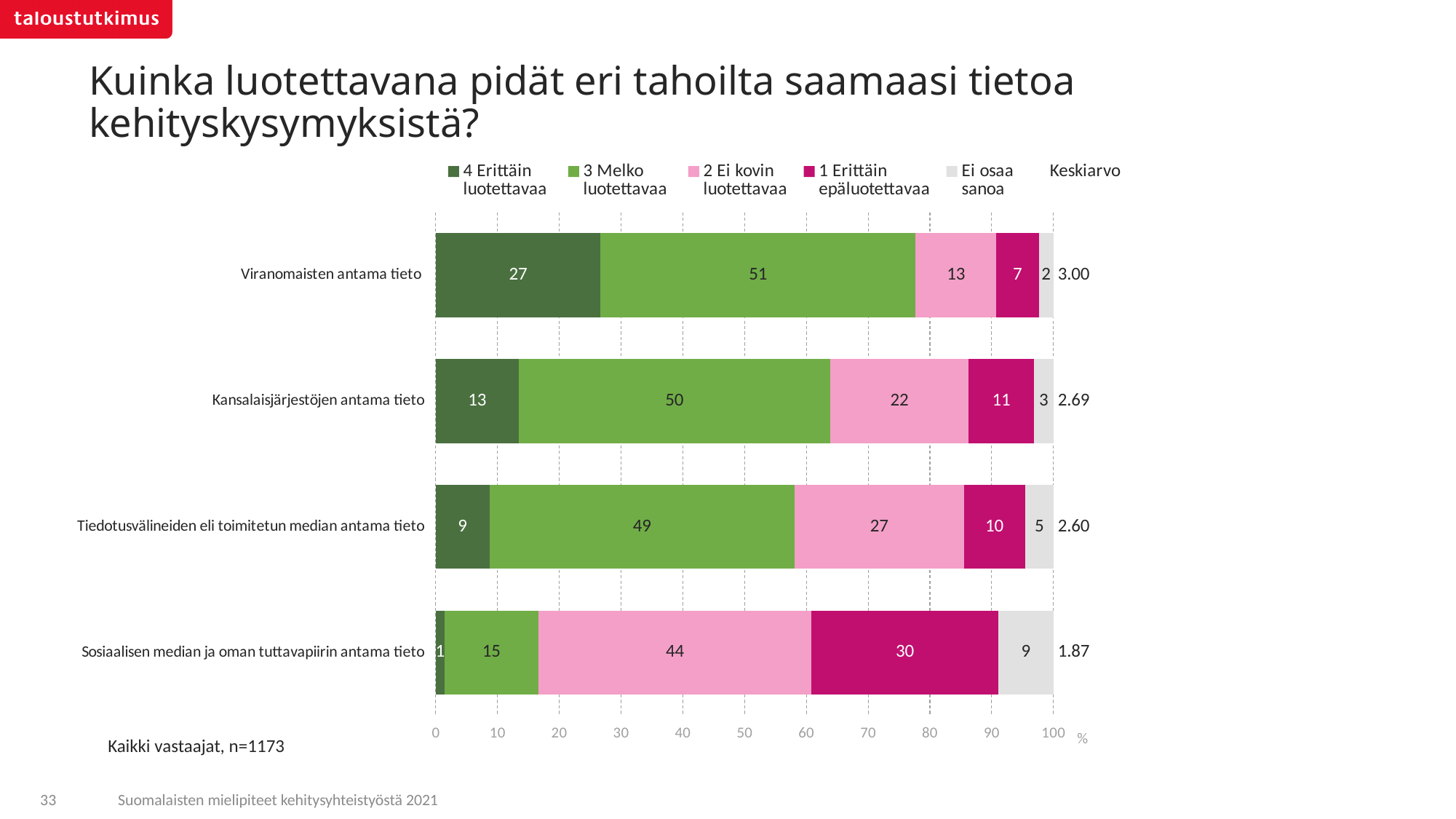
What type of chart is shown on the slide? Stacked bar chart What percentage of respondents rated information from authorities (Viranomaisten antama tieto) as '4 Erittäin luotettavaa'? 27 Which is larger: the '2 Ei kovin luotettavaa' value for Kansalaisjärjestöjen antama tieto or for Tiedotusvälineiden eli toimitetun median antama tieto? Tiedotusvälineiden eli toimitetun median antama tieto What is the Keskiarvo (mean) shown for Kansalaisjärjestöjen antama tieto? 2.69 What is the sample size stated below the chart? n=1173 What is the total of the stacked bar for Viranomaisten antama tieto? 100 What is the 'Ei osaa sanoa' value for Tiedotusvälineiden eli toimitetun median antama tieto? 5 What is the '2 Ei kovin luotettavaa' value for Sosiaalisen median ja oman tuttavapiirin antama tieto? 44 How many information sources (bars) are shown in the chart? 4 Which source has the lowest Keskiarvo value? Sosiaalisen median ja oman tuttavapiirin antama tieto Which source has the highest '1 Erittäin epäluotettavaa' share? Sosiaalisen median ja oman tuttavapiirin antama tieto What is the difference between the '3 Melko luotettavaa' values for Viranomaisten antama tieto and Sosiaalisen median ja oman tuttavapiirin antama tieto? 36